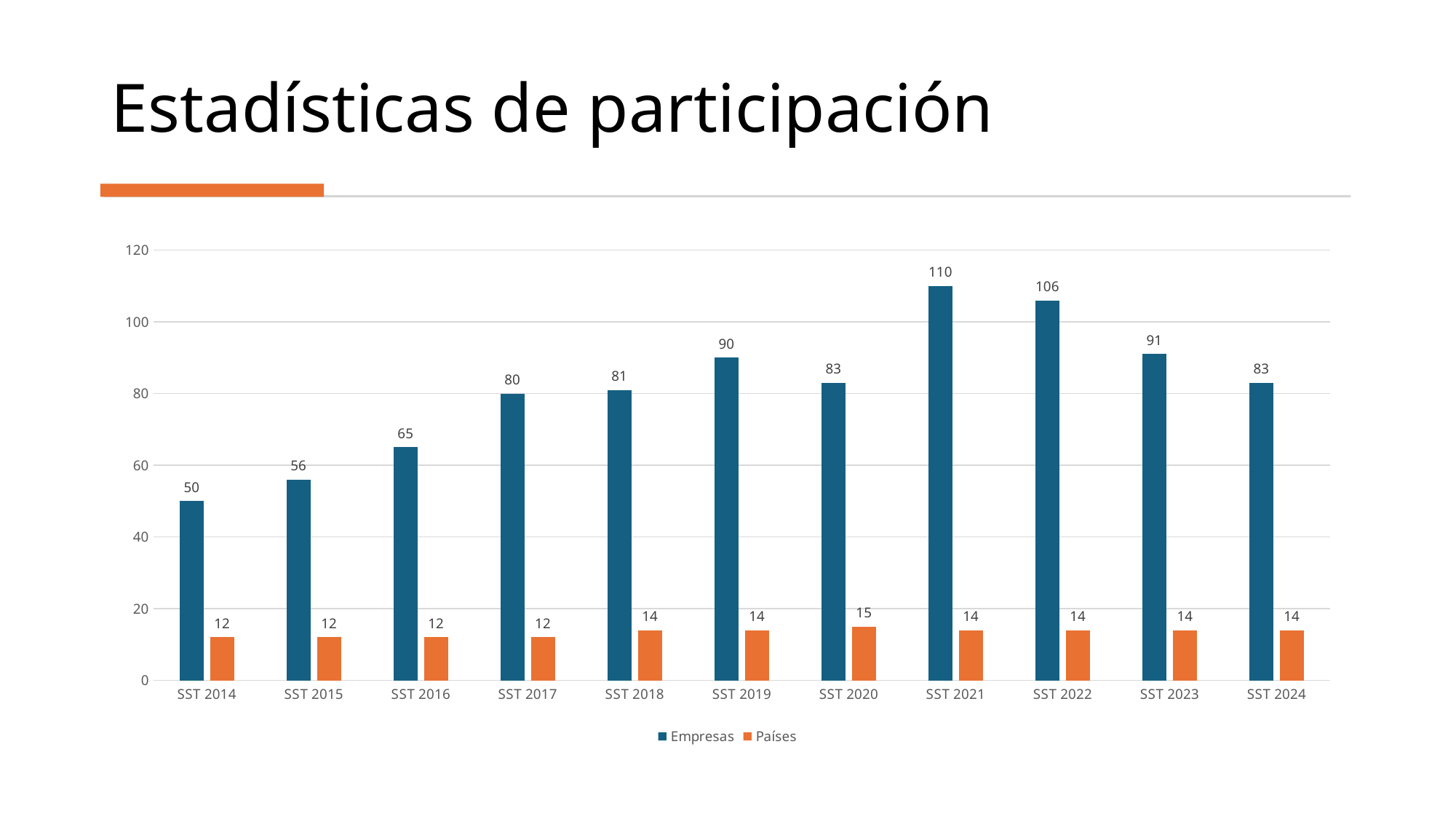
What is the Empresas value for SST 2014? 50 What is the difference between the Empresas values for SST 2021 and SST 2022? 4 Which category has the highest Empresas value? SST 2021 Is the Empresas value for SST 2017 greater or less than 60? greater How many categories are shown on the x axis? 11 What is the Países value for SST 2020? 15 What is the Empresas value for SST 2021? 110 What kind of chart is shown on the slide? bar chart What is the title of the slide? Estadísticas de participación Which category has the lowest Empresas value? SST 2014 Which is larger, the Empresas value for SST 2019 or for SST 2023? SST 2023 How many series does the legend list? 2